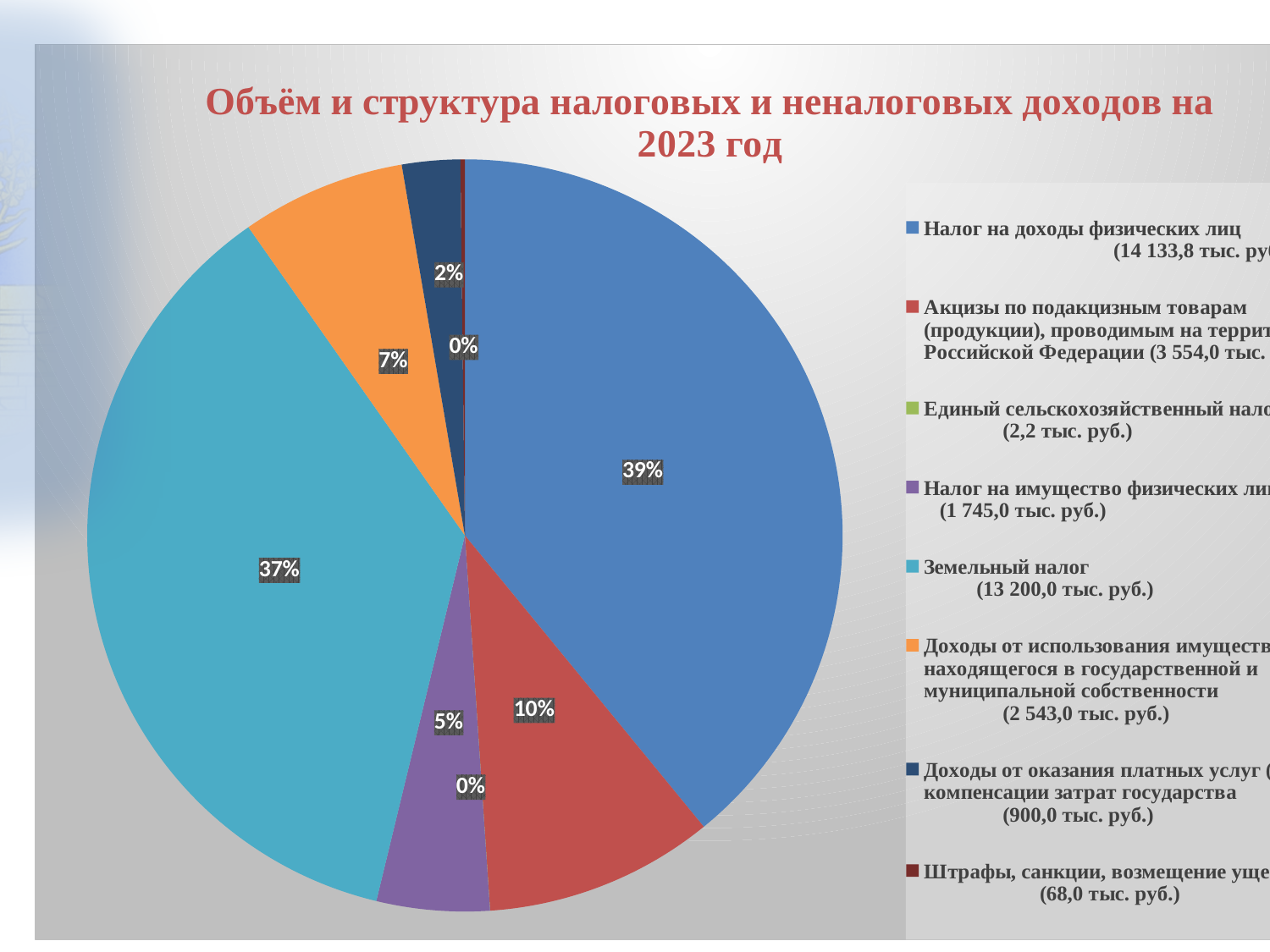
Which slice is larger: Земельный налог or Акцизы по подакцизным товарам? Земельный налог What is the difference in percentage points between the Налог на доходы физических лиц slice and the Земельный налог slice? 2 percentage points What share of the pie does Земельный налог account for? 37% What percentage is shown for the Налог на имущество физических лиц slice? 5% What percentage is shown for the Доходы от оказания платных услуг и компенсации затрат государства slice? 2% What is the title of the chart? Объём и структура налоговых и неналоговых доходов на 2023 год How many slices (categories) does the pie chart have? 8 Which category has the largest slice of the pie? Налог на доходы физических лиц What amount does the legend give for Земельный налог? 13 200,0 тыс. руб. What kind of chart is shown on the slide? pie chart